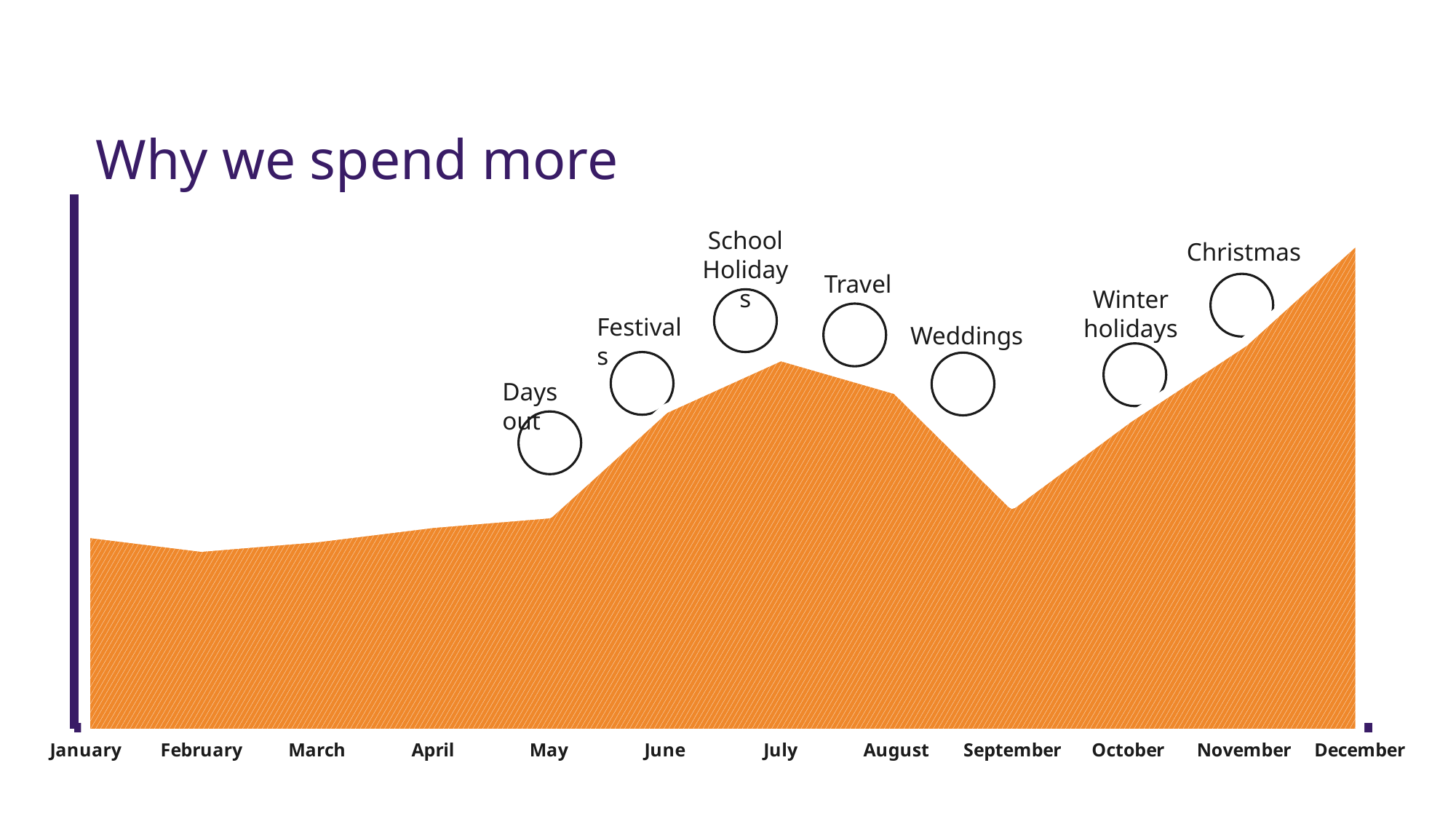
What kind of chart is shown on the slide? Area chart Do the values rise or fall from September to December? Rise Which month has the highest value in the chart? December Which is larger, the value for September or the value for January? September Do the values rise or fall from July to September? Fall Which is larger, the value for July or the value for September? July Which is larger, the value for December or the value for July? December What is the title of the slide? Why we spend more How many months are shown along the x axis of the chart? 12 Do the values rise or fall from April to July? Rise How many labelled reasons (such as 'Days out' and 'Christmas') are annotated above the chart? 7